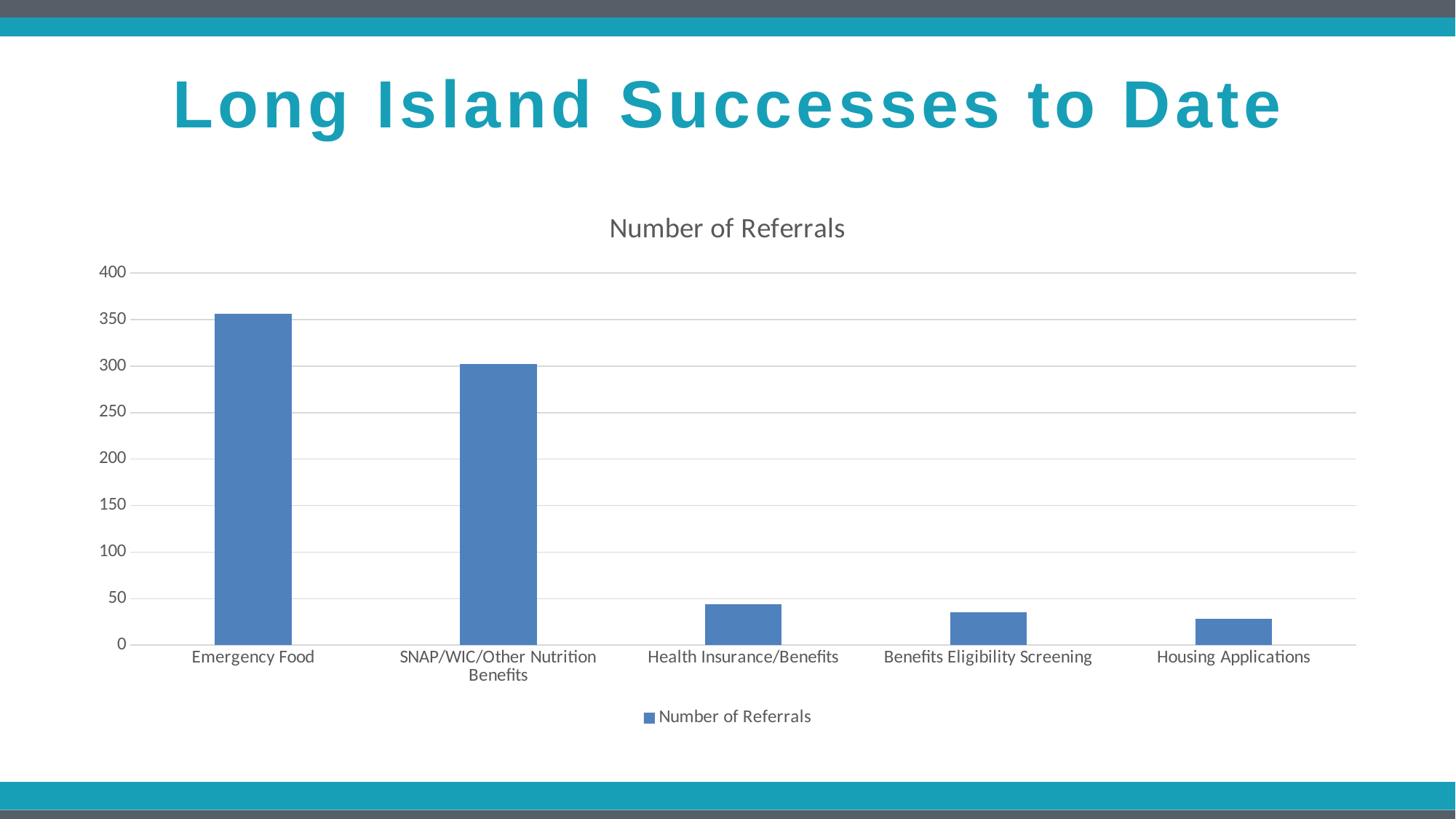
Which has more referrals, Emergency Food or SNAP/WIC/Other Nutrition Benefits? Emergency Food What is the title of the chart? Number of Referrals Is the value for Housing Applications greater or less than 50? less Is the value for SNAP/WIC/Other Nutrition Benefits greater or less than 250? greater Which category has the lowest number of referrals? Housing Applications How many categories are shown on the x axis of the chart? 5 Is the value for Health Insurance/Benefits greater or less than 50? less Which category has the highest number of referrals? Emergency Food Which has more referrals, Health Insurance/Benefits or Housing Applications? Health Insurance/Benefits What type of chart is shown on the slide? bar chart How many series does the legend list? 1